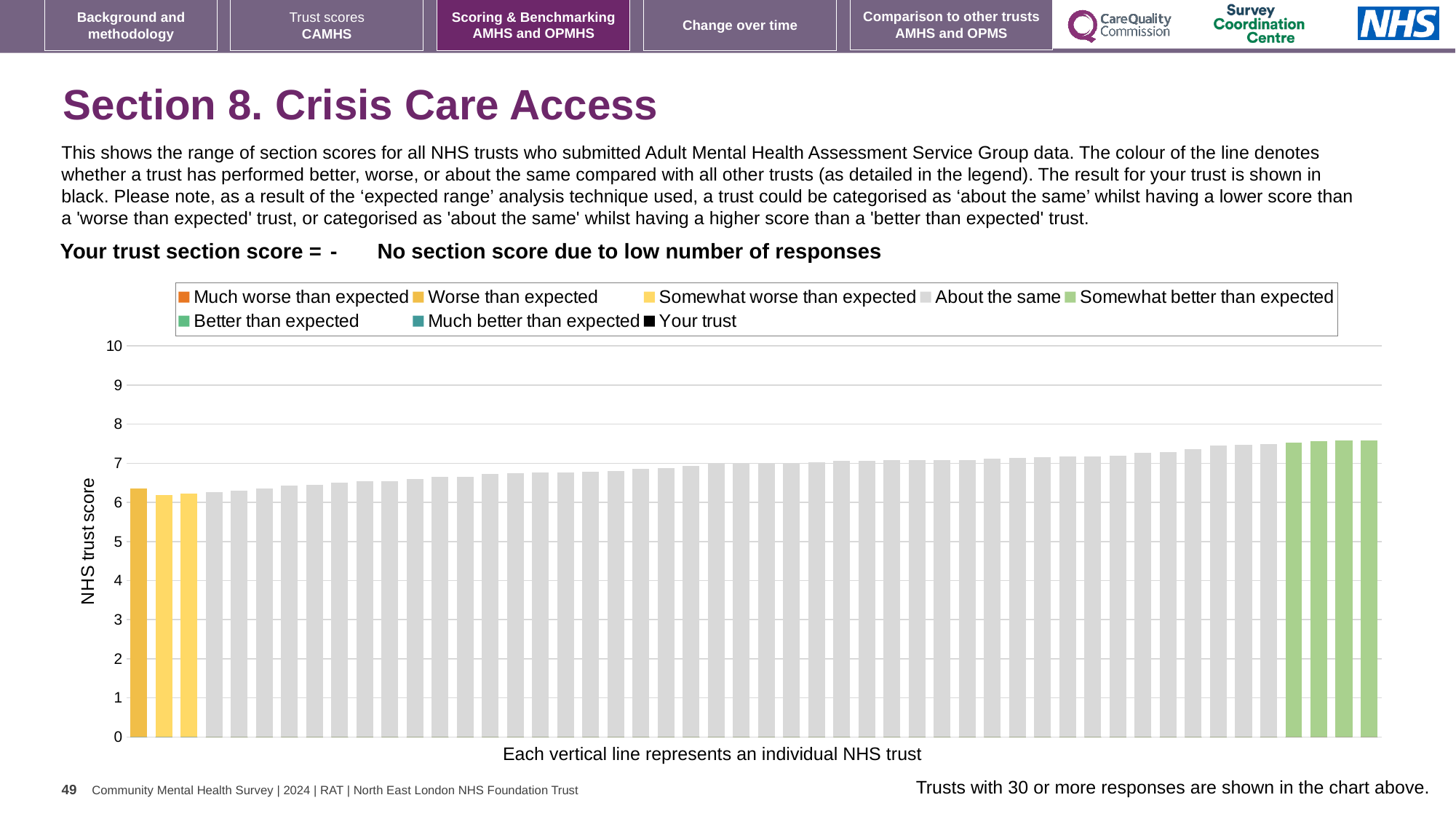
What kind of chart is shown on the slide? bar chart Is the value of the leftmost bar greater or less than 7? less How many entries does the chart legend list? 8 Do the bar values rise or fall from left to right across the chart? rise How many bars are coloured green (somewhat better than expected) in the chart? 4 What is the label on the vertical axis of the chart? NHS trust score Is the value of the rightmost bar greater or less than 7? greater Is the value of the leftmost bar greater or less than 6? greater What is the label beneath the horizontal axis of the chart? Each vertical line represents an individual NHS trust What is the highest value shown on the vertical axis of the chart? 10 How many bars are coloured yellow (worse or somewhat worse than expected) in the chart? 3